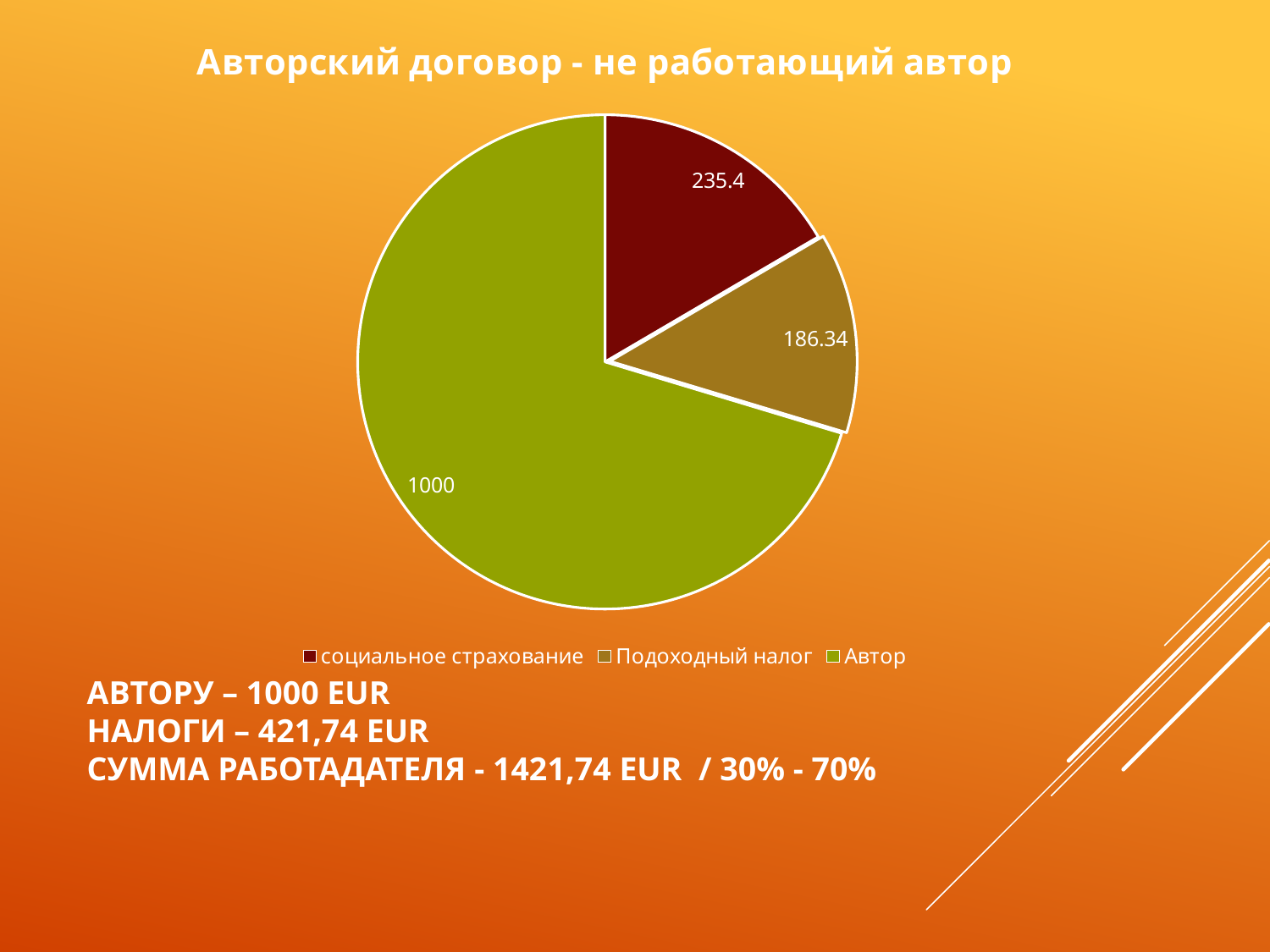
What is the value of the Автор slice in the pie chart? 1000 What is the value of the социальное страхование slice? 235.4 What type of chart is shown on the slide? Pie chart What is the difference between the Автор and социальное страхование values? 764.6 What is the title of the chart? Авторский договор - не работающий автор What is the total of all slices in the pie chart? 1421.74 What is the difference between the социальное страхование and Подоходный налог values? 49.06 How many slices does the pie chart have? 3 What is the value of the Подоходный налог slice? 186.34 Which category has the smallest slice in the pie chart? Подоходный налог Which is larger, социальное страхование or Подоходный налог? социальное страхование Which category has the largest slice in the pie chart? Автор